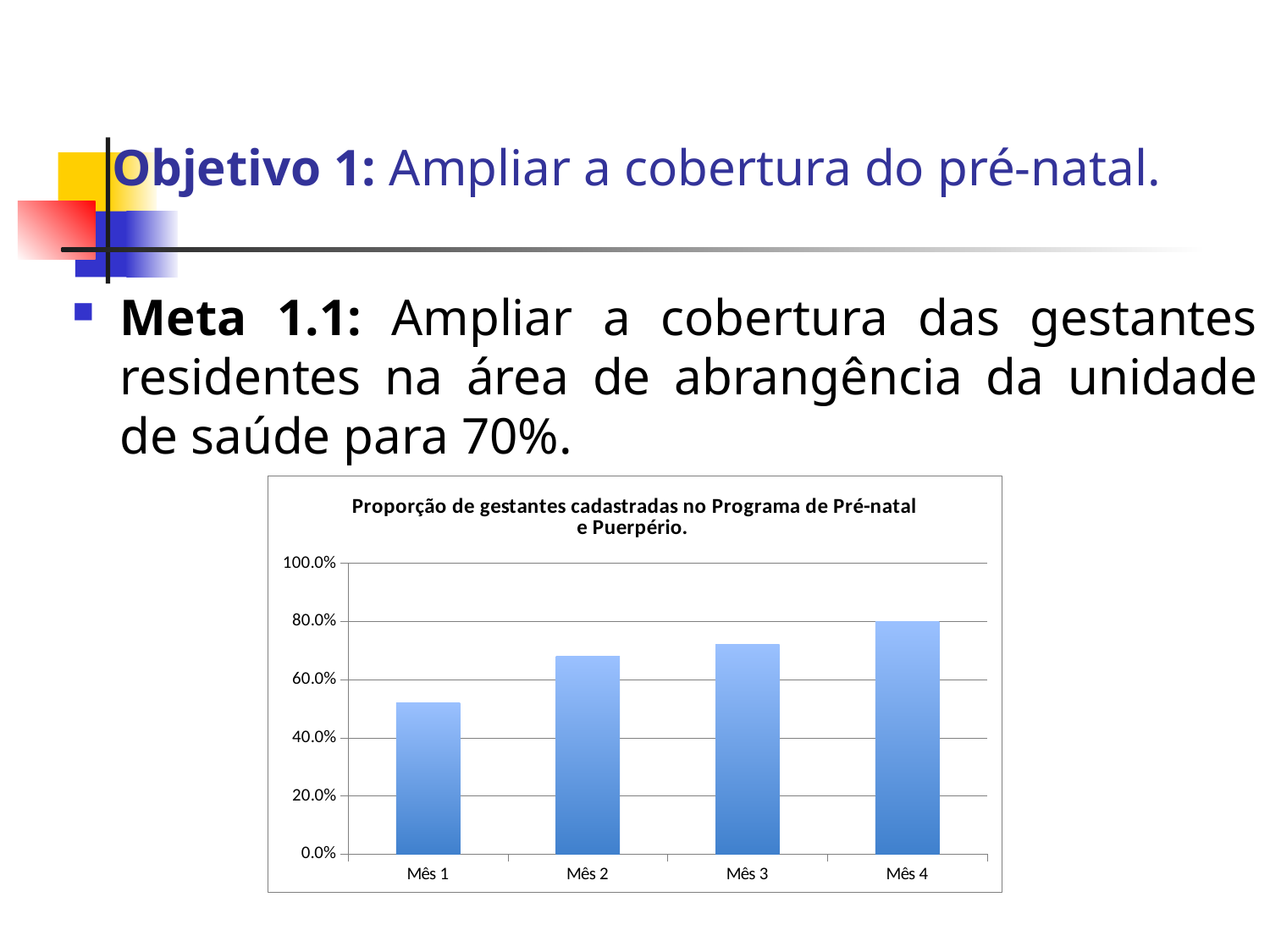
Is the value for Mês 1 greater or less than 40.0%? greater Is the value for Mês 2 greater or less than 60.0%? greater How many categories (months) are plotted on the chart? 4 Which month has the lowest proportion of registered pregnant women? Mês 1 Which month has the highest proportion of registered pregnant women? Mês 4 Do the values rise or fall from Mês 1 to Mês 4? rise Is the value for Mês 1 greater or less than 60.0%? less Which is larger, the value for Mês 1 or the value for Mês 3? Mês 3 What is the title of the chart? Proporção de gestantes cadastradas no Programa de Pré-natal e Puerpério. What kind of chart is shown on the slide? bar chart